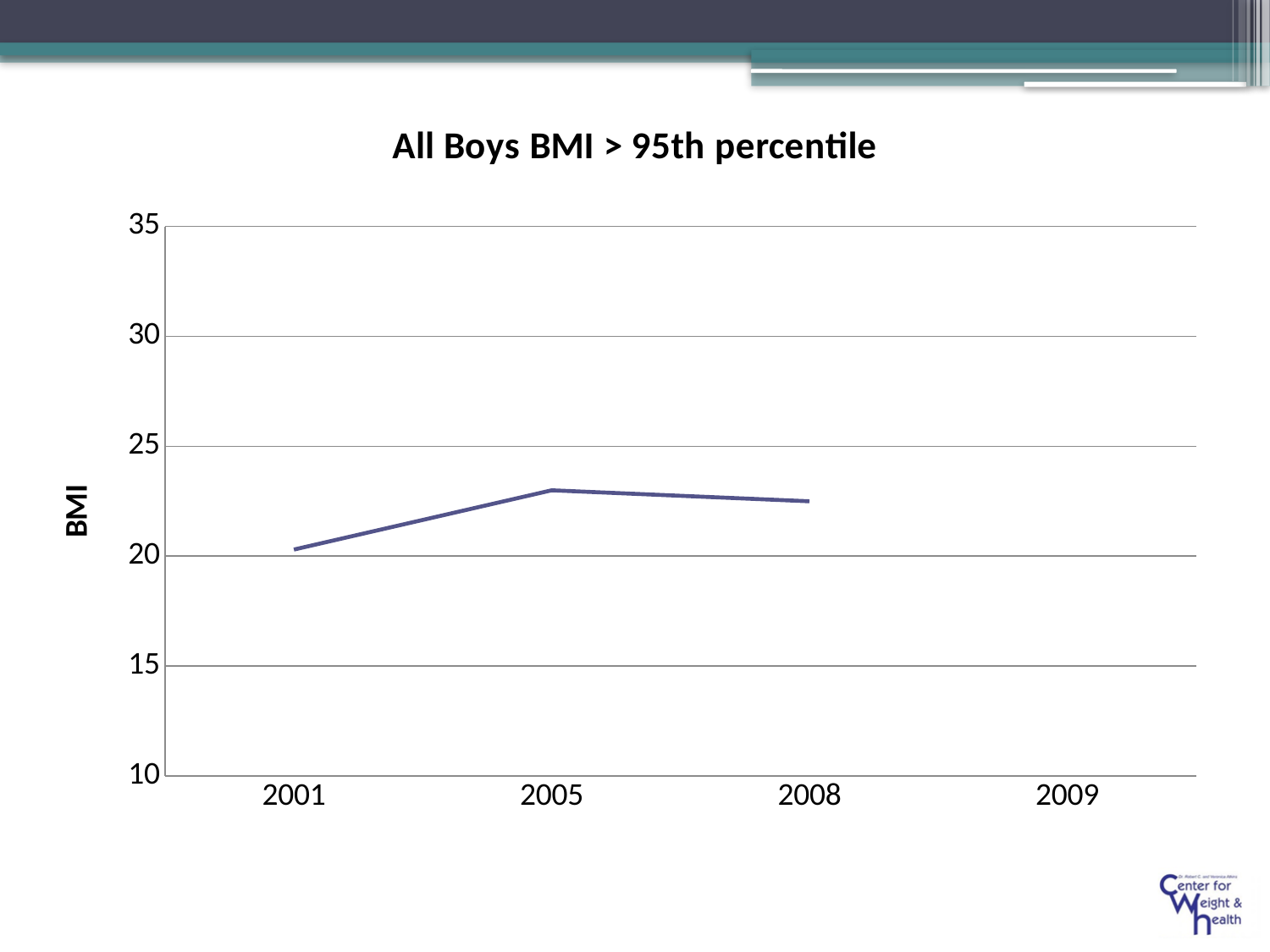
What kind of chart is shown on the slide? line chart Is the BMI value for 2008 greater or less than 20? greater How many years are labelled on the x axis of the chart? 4 Which year has the highest plotted BMI value? 2005 Which is larger, the BMI value for 2001 or for 2005? 2005 Is the BMI value for 2005 greater or less than 25? less What is the title of the chart? All Boys BMI > 95th percentile Which year has the lowest plotted BMI value? 2001 Does the BMI value rise or fall from 2001 to 2005? rise What is the label on the vertical axis of the chart? BMI Does the BMI value rise or fall from 2005 to 2008? fall How many data points are plotted on the line in the chart? 3